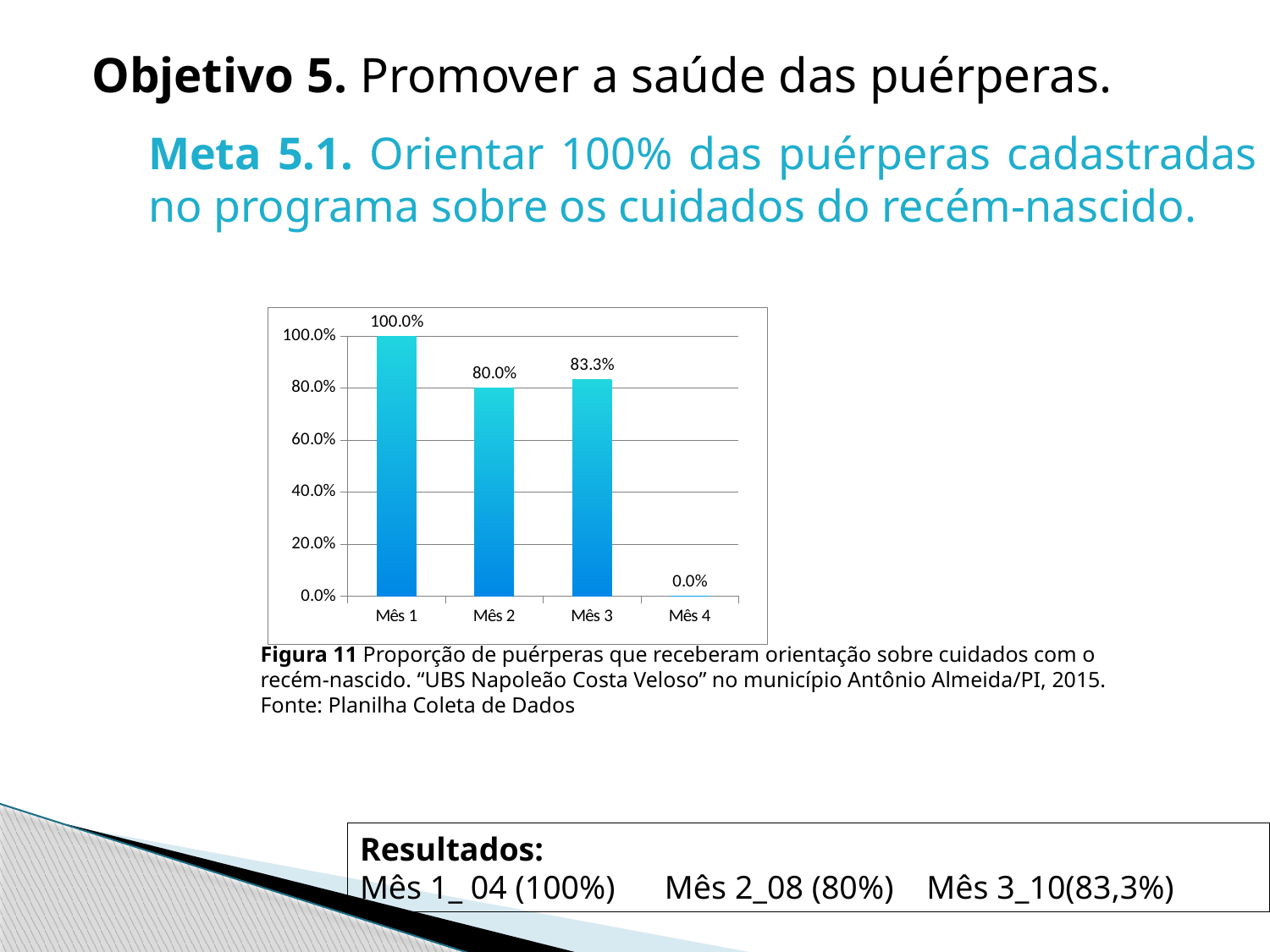
What is the value for Mês 2? 80.0% What is the figure number given in the caption below the chart? Figura 11 What is the value for Mês 3? 83.3% What is the value for Mês 1? 100.0% What is the difference between the values for Mês 1 and Mês 2? 20.0% What kind of chart is shown on the slide? Bar chart Which month has the lowest value? Mês 4 Which month has the highest value? Mês 1 How many months are shown on the x axis of the chart? 4 What is the difference between the values for Mês 3 and Mês 2? 3.3% Which is larger, the value for Mês 2 or the value for Mês 3? Mês 3 What is the value for Mês 4? 0.0%